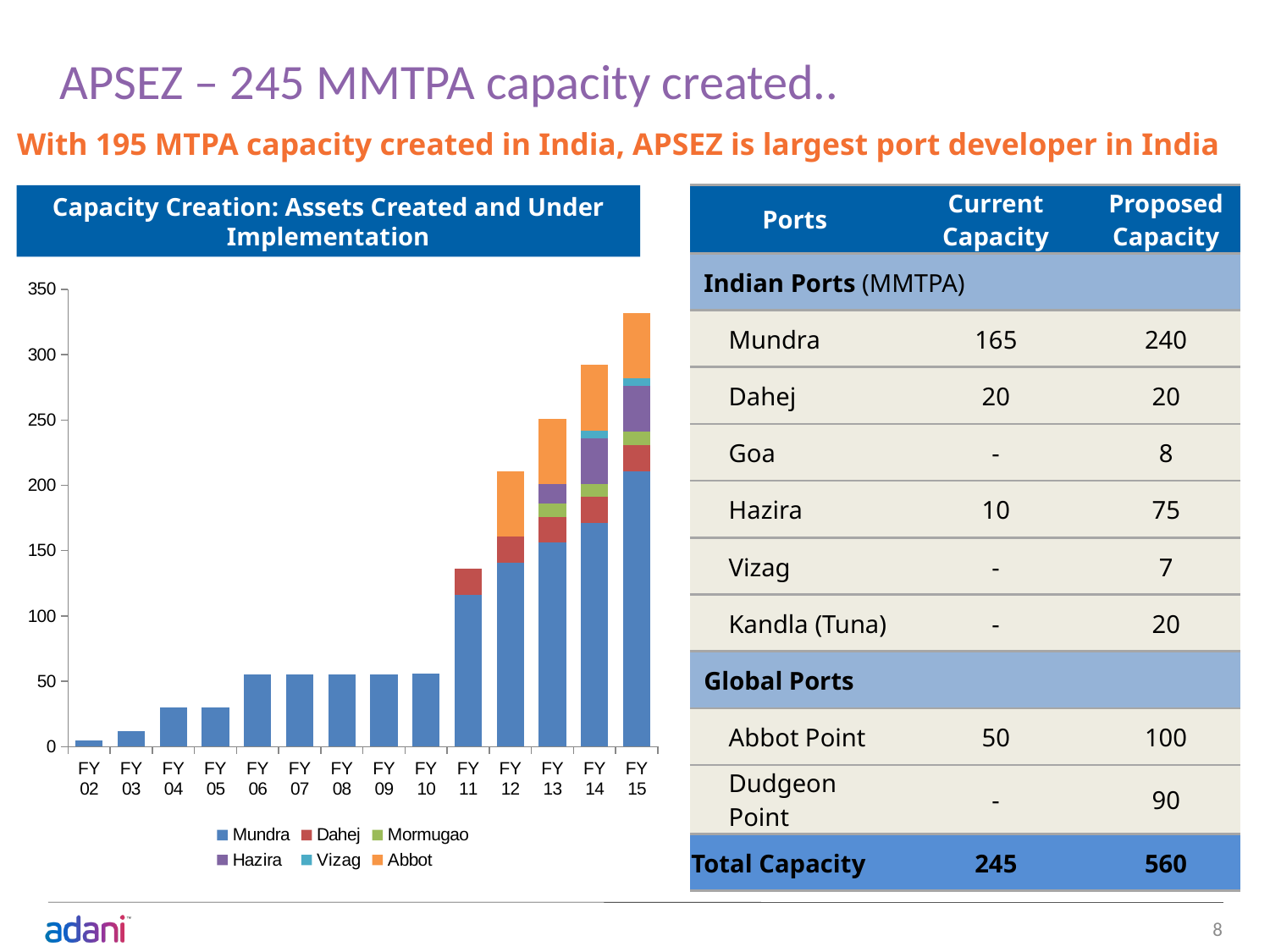
Is the total stacked value for FY 14 greater or less than 250? greater Which fiscal year has the tallest stacked bar in the chart? FY 15 What is the title of the chart on the slide? Capacity Creation: Assets Created and Under Implementation Which fiscal year has the shortest stacked bar in the chart? FY 02 How many series does the chart's legend list? 6 How many fiscal years are shown along the x axis of the chart? 14 Is the total stacked value for FY 11 greater or less than 100? greater Is the total stacked value for FY 02 greater or less than 50? less What kind of chart is shown on the slide? Stacked bar chart Do the total stacked values generally rise or fall from FY 02 to FY 15? rise Which has the larger total stacked bar, FY 11 or FY 15? FY 15